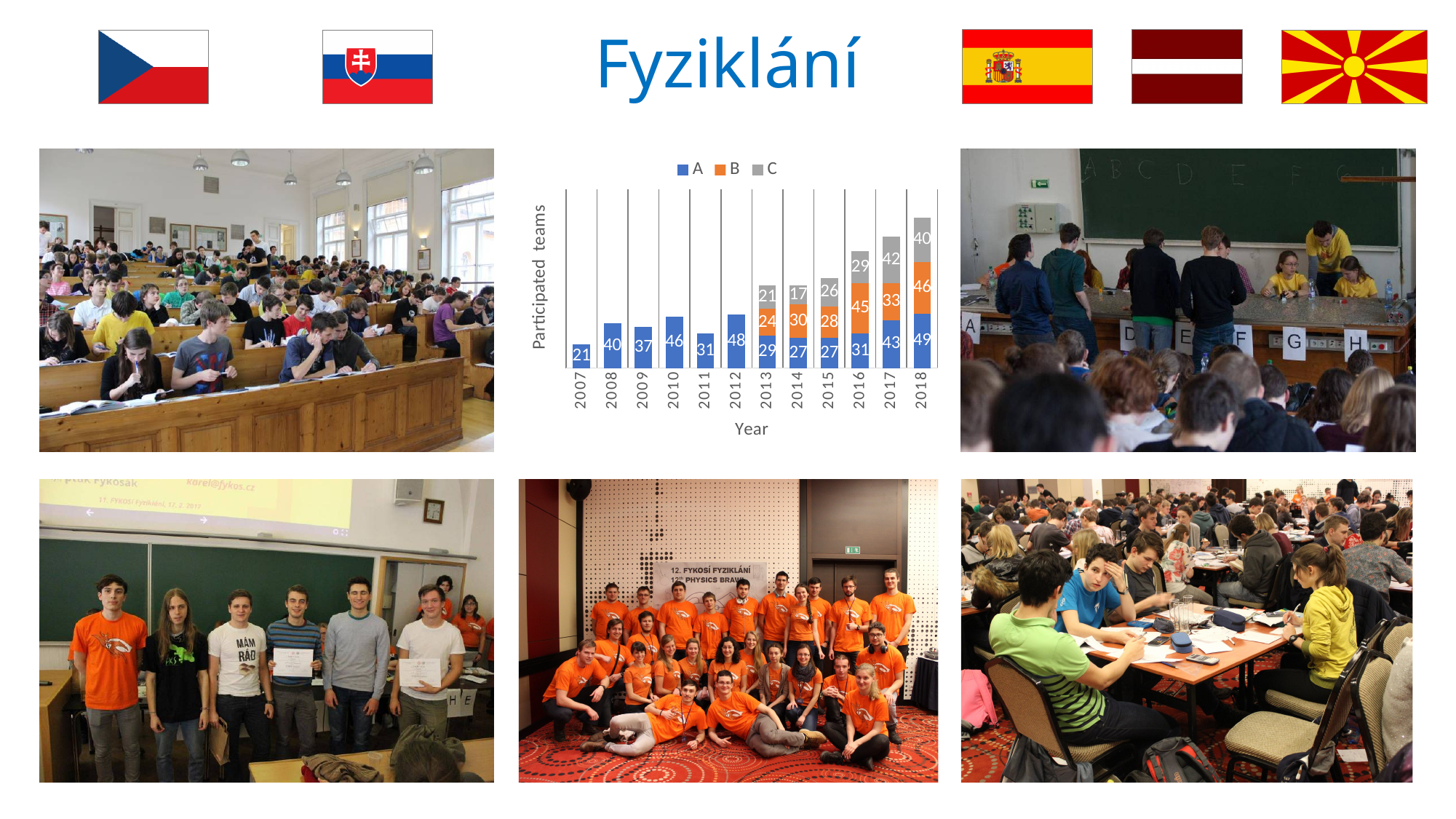
What is the total number of participated teams in 2018 across all series? 135 How many years are shown on the x axis of the chart? 12 Which is larger in 2014: the value of series B or the value of series C? B How many series does the chart legend list? 3 What is the value of series C in 2017? 42 What is the value of series A in 2007? 21 What is the value of series B in 2016? 45 What kind of chart is shown on the slide? stacked bar chart What is the difference between the value of series A in 2012 and in 2011? 17 In which year is the value of series A the highest? 2018 In which year is the value of series A the lowest? 2007 What is the label of the y axis of the chart? Participated teams